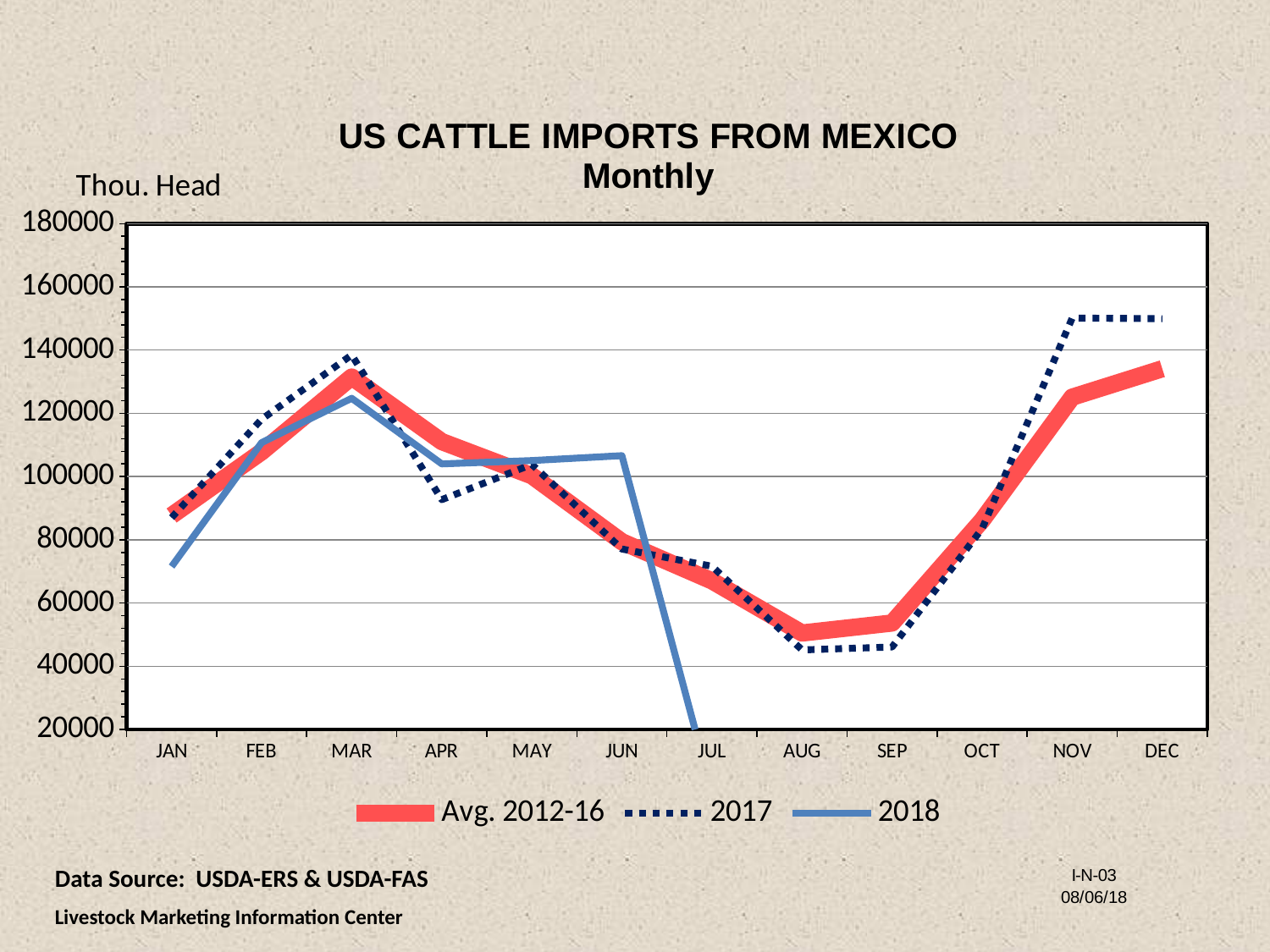
What kind of chart is shown on the slide? Line chart Is the 2017 value for NOV greater or less than 140000? greater Is the Avg. 2012-16 value for AUG greater or less than 60000? less Does the 2017 series rise or fall from MAR to AUG? Fall How many months are shown along the x axis? 12 Is the 2017 value for APR greater or less than 100000? less In NOV, which is larger: the 2017 value or the Avg. 2012-16 value? 2017 Which month has the highest value for the 2018 series? MAR What unit is shown on the y axis label? Thou. Head In APR, which is larger: the Avg. 2012-16 value or the 2017 value? Avg. 2012-16 How many series does the legend list? 3